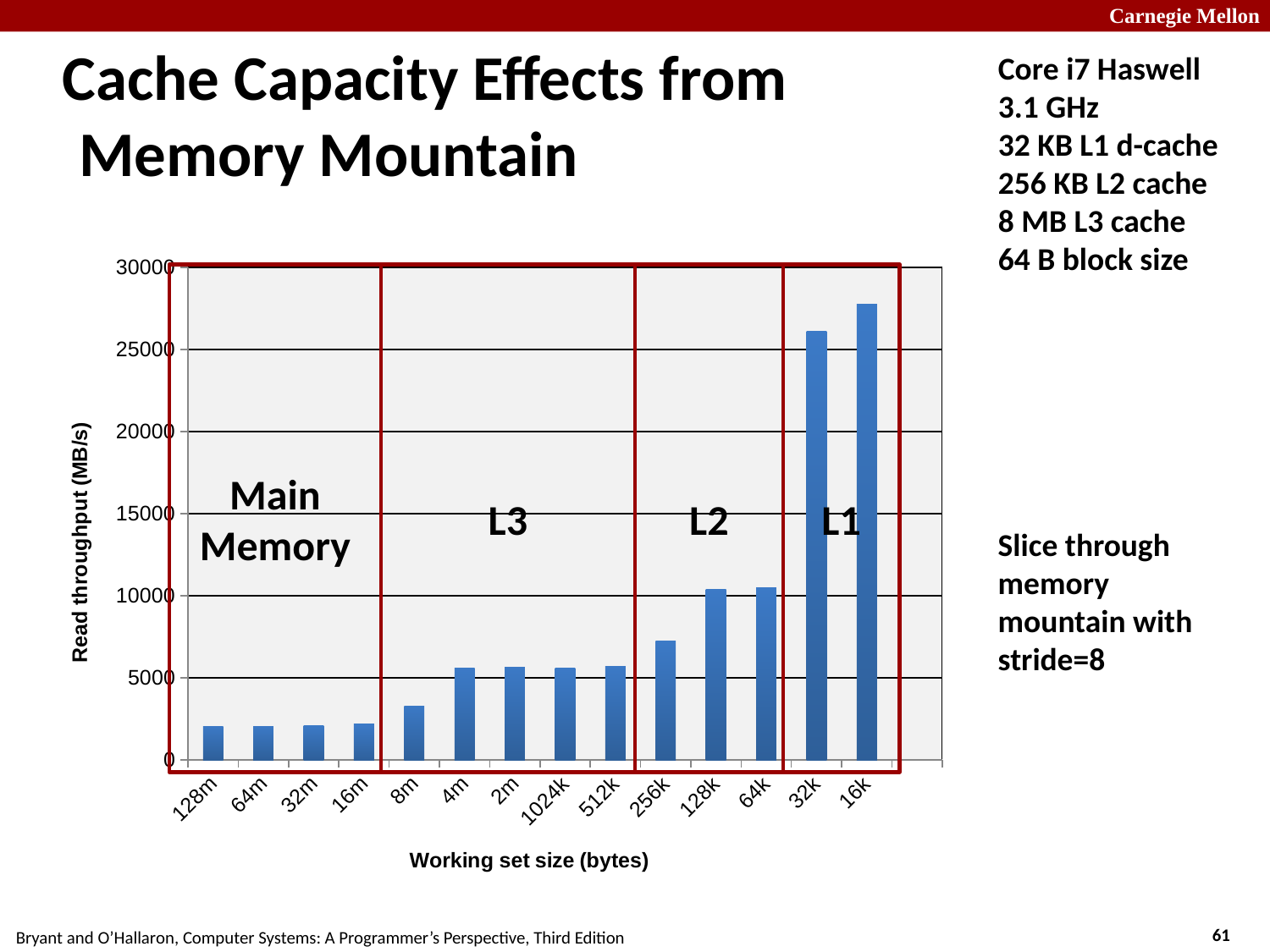
What is the label on the y axis of the chart? Read throughput (MB/s) How many working set sizes are plotted along the x axis? 14 Which has the higher read throughput, a working set size of 8m or 128m? 8m Which working set size has the highest read throughput? 16k Is the read throughput for a working set size of 128m greater or less than 5000? less What kind of chart is shown on the slide? bar chart Which has the higher read throughput, a working set size of 32k or 256k? 32k Is the read throughput for a working set size of 8m greater or less than 5000? less Is the read throughput for a working set size of 256k greater or less than 5000? greater Do the bars generally rise or fall moving from left to right along the x axis? rise